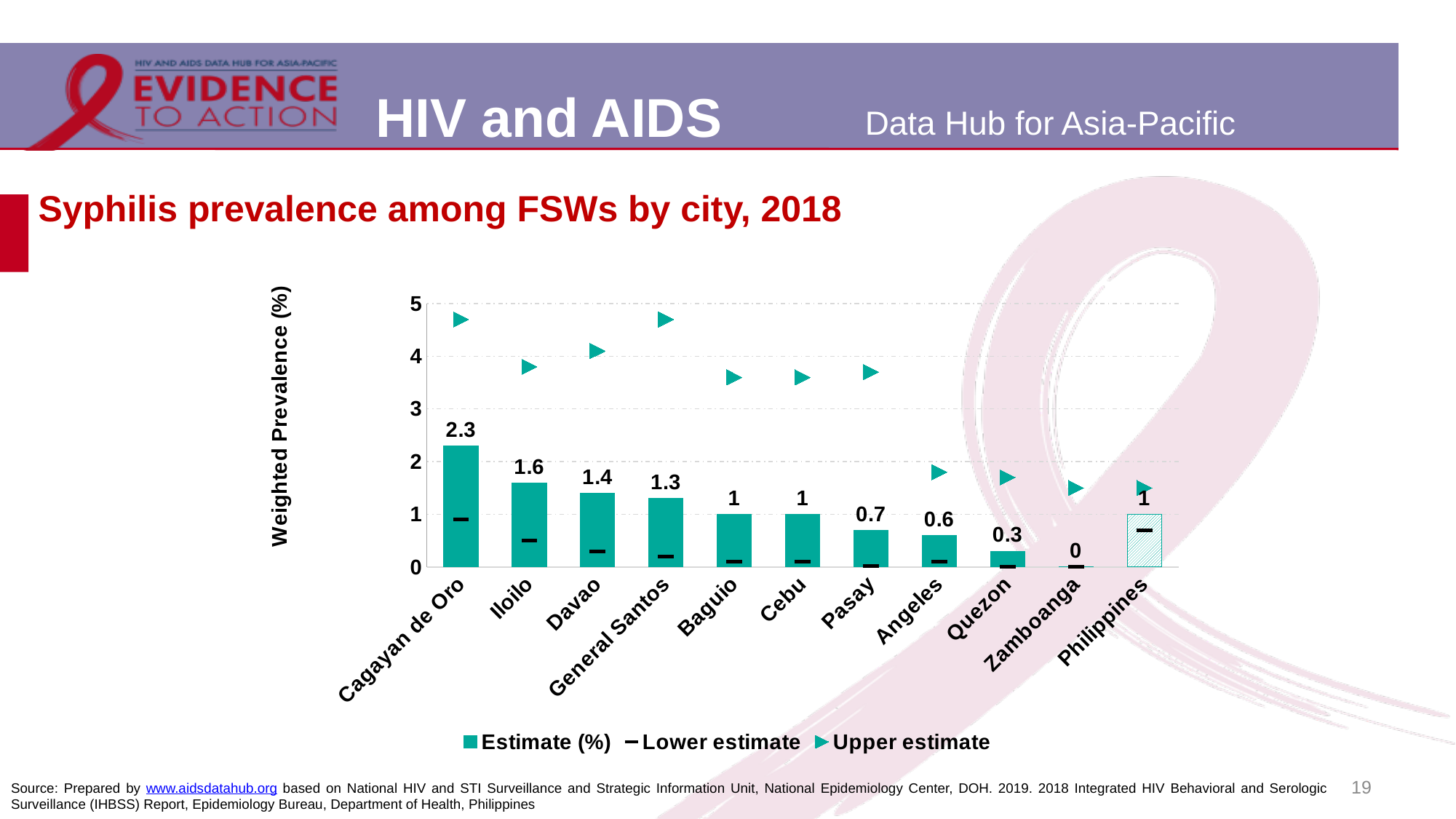
Which has a higher estimated prevalence, Davao or Angeles? Davao Is the upper estimate for Cagayan de Oro greater or less than 4? greater What is the estimated syphilis prevalence (%) among FSWs in Iloilo? 1.6 What is the difference between the estimated prevalence in Cagayan de Oro and in Iloilo? 0.7 What is the estimated syphilis prevalence (%) among FSWs in Cagayan de Oro? 2.3 Which city has the lowest estimated syphilis prevalence among FSWs? Zamboanga How many cities or areas are shown on the x axis of the chart? 11 How many series does the chart legend list? 3 What is the estimated syphilis prevalence (%) for the Philippines overall? 1 What is the estimated syphilis prevalence (%) among FSWs in Pasay? 0.7 What type of chart is used to show the estimate (%) values? Bar chart Which city has the highest estimated syphilis prevalence among FSWs? Cagayan de Oro